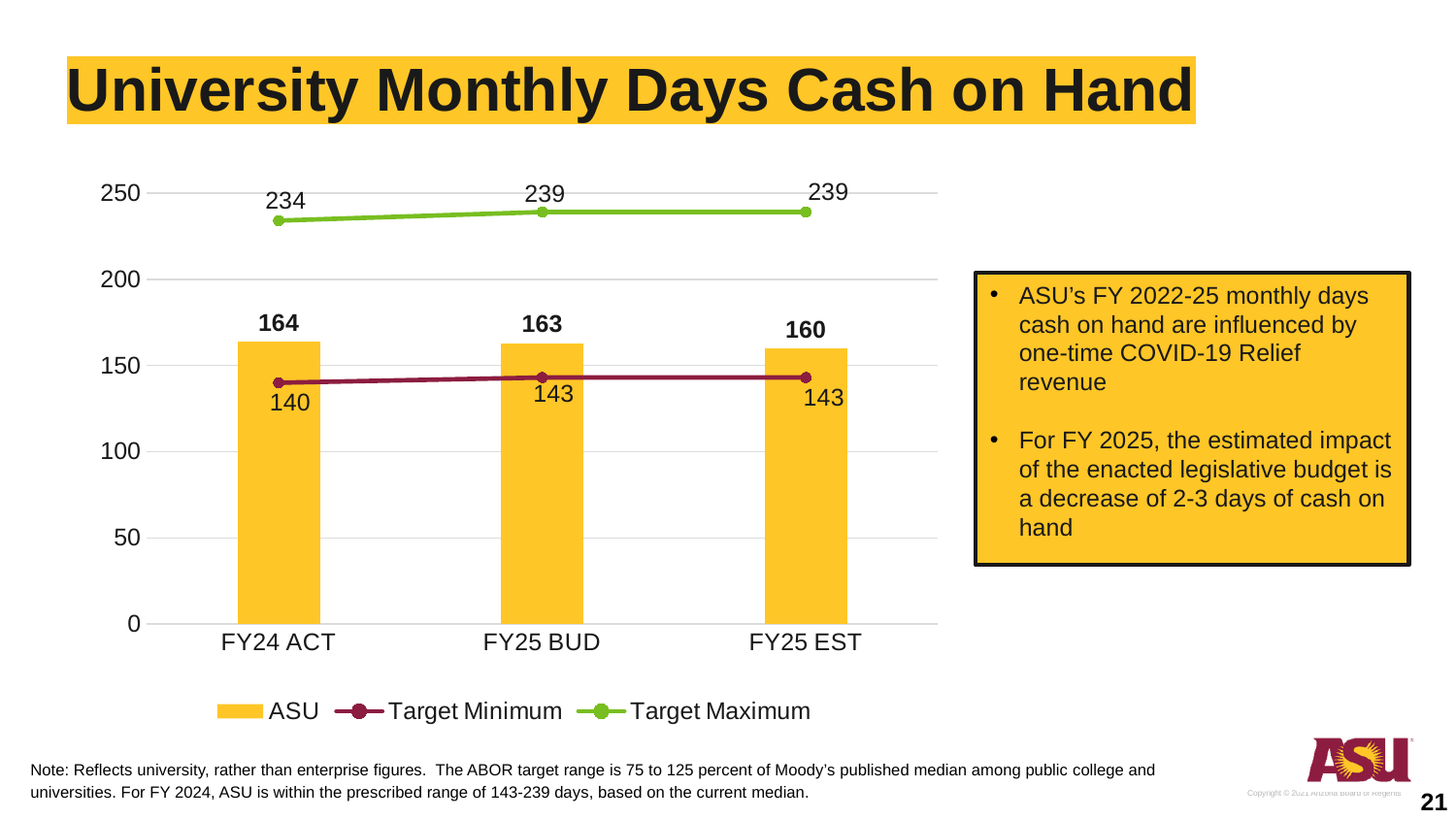
What is the Target Maximum value for FY24 ACT? 234 Which category has the lowest ASU value? FY25 EST What is the ASU value for FY24 ACT? 164 What is the difference between the ASU value for FY24 ACT and the ASU value for FY25 EST? 4 Do the ASU values rise or fall from FY24 ACT to FY25 EST? fall What is the ASU value for FY25 EST? 160 Which category has the highest ASU value? FY24 ACT Which is larger, the ASU value for FY25 BUD or the Target Minimum for FY25 BUD? ASU value for FY25 BUD How many categories are shown on the x axis? 3 What is the difference between the Target Maximum and Target Minimum for FY25 BUD? 96 What is the Target Minimum value for FY25 BUD? 143 How many series does the legend list? 3